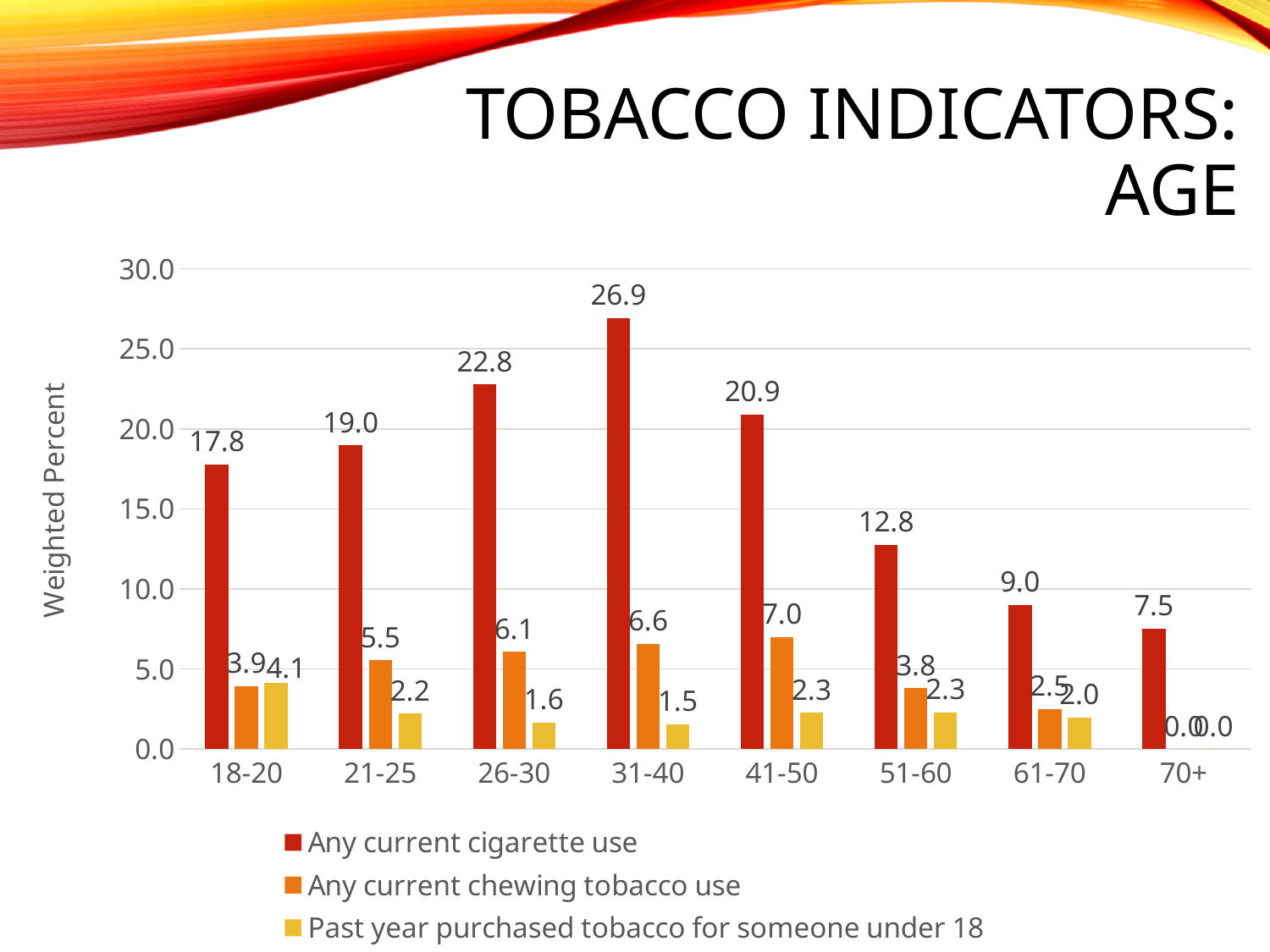
What is the value for 'Any current cigarette use' in the 31-40 age group? 26.9 How many series does the legend list? 3 What kind of chart is shown on the slide? bar chart Is the value for 'Any current cigarette use' in the 51-60 age group greater or less than 15.0? less What is the value for 'Past year purchased tobacco for someone under 18' in the 18-20 age group? 4.1 What is the difference between 'Any current cigarette use' for the 31-40 and 18-20 age groups? 9.1 What is the label of the y axis? Weighted Percent How many age groups are shown on the x axis? 8 Which age group has the highest value for 'Any current cigarette use'? 31-40 Which age group has the lowest value for 'Any current cigarette use'? 70+ Which is larger: 'Any current chewing tobacco use' for 26-30 or for 21-25? 26-30 What is the value for 'Any current chewing tobacco use' in the 41-50 age group? 7.0